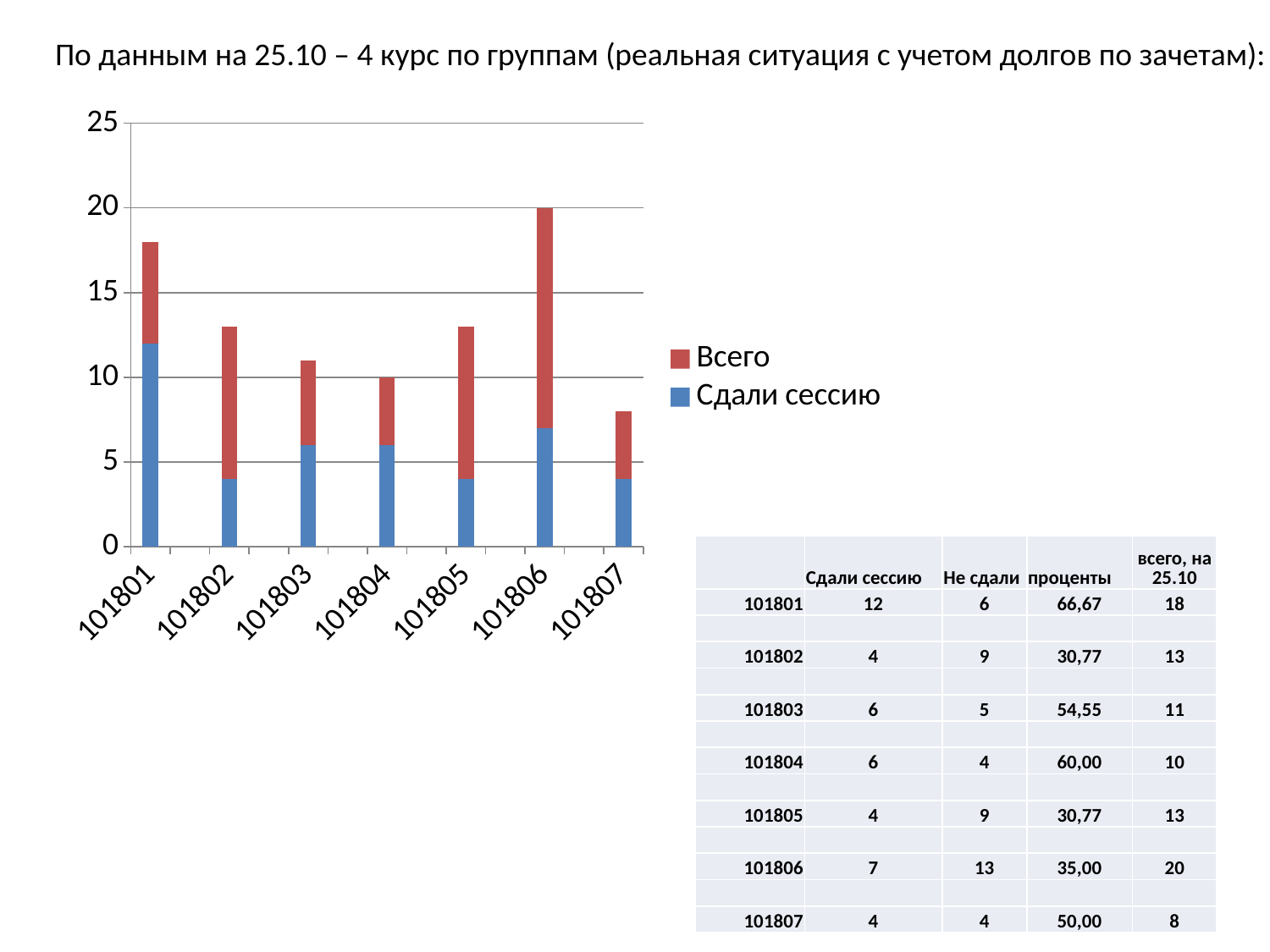
Which group has the tallest bar in the chart? 101806 Which group has a taller bar, 101801 or 101802? 101801 What is the difference between the total bar heights of groups 101806 and 101804? 10 How many groups are shown on the x axis of the chart? 7 What is the total height of the bar for group 101804? 10 Is the total bar height for group 101807 greater or less than 10? less Which group has the shortest bar in the chart? 101807 What are the two entries in the chart legend? Всего, Сдали сессию Is the total bar height for group 101801 greater or less than 15? greater What is the total height of the bar for group 101806? 20 How many series does the chart legend list? 2 What kind of chart is shown on the slide? bar chart